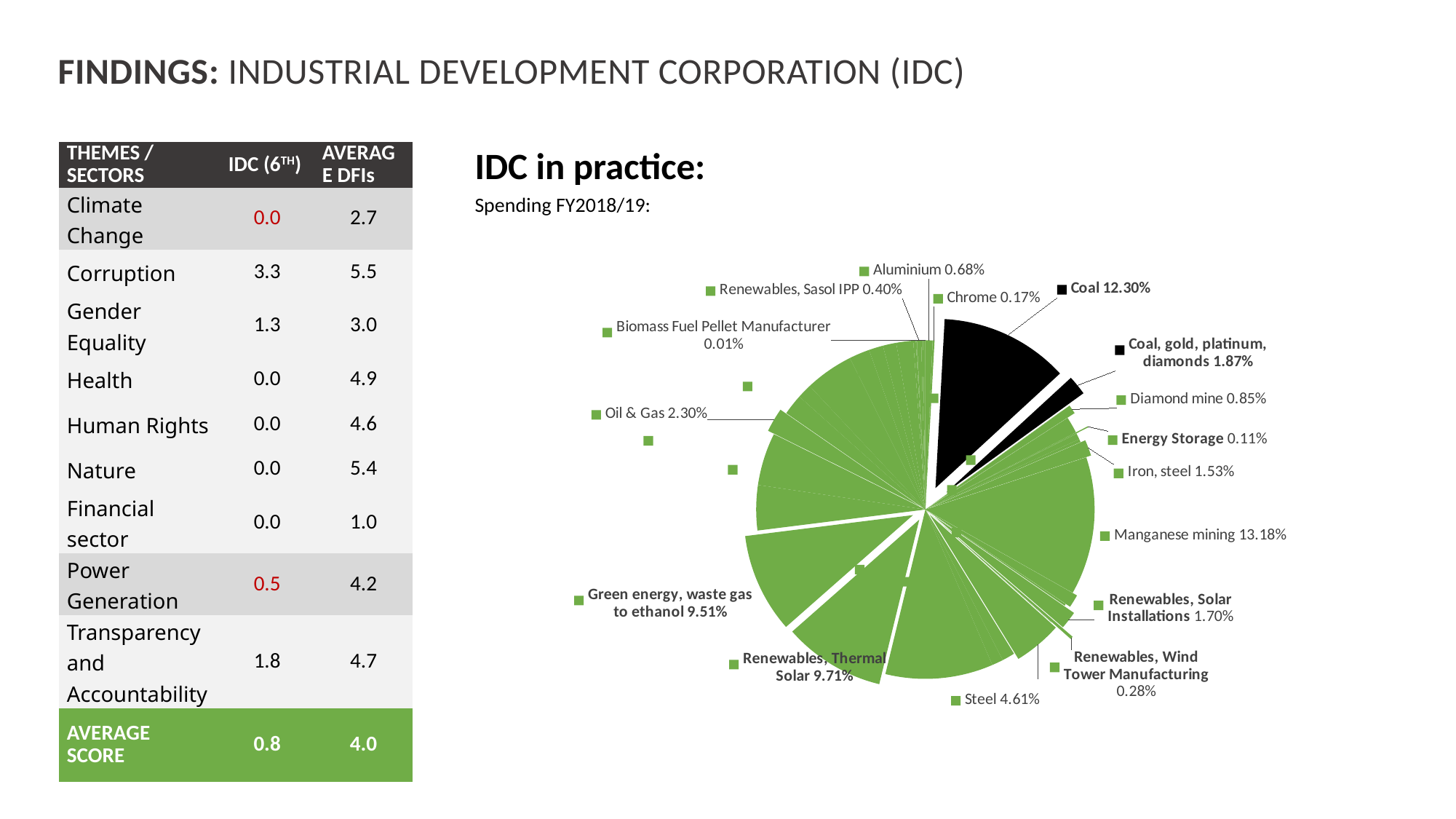
Which labelled category has the smallest share in the pie chart? Biomass Fuel Pellet Manufacturer What kind of chart is shown under "IDC in practice"? pie chart What is the share for Renewables, Thermal Solar in the pie chart? 9.71% What is the share for Oil & Gas in the pie chart? 2.30% What share of spending does Coal account for in the pie chart? 12.30% Which labelled category has the largest share in the pie chart? Manganese mining What colour are the Coal-related slices in the pie chart? black What is the difference in share between Manganese mining and Coal in the pie chart? 0.88% What is the share for Steel in the pie chart? 4.61% What is the difference in share between Coal and Oil & Gas in the pie chart? 10.00% Which has the larger share in the pie chart, Coal or Green energy, waste gas to ethanol? Coal What share of spending does Manganese mining account for in the pie chart? 13.18%